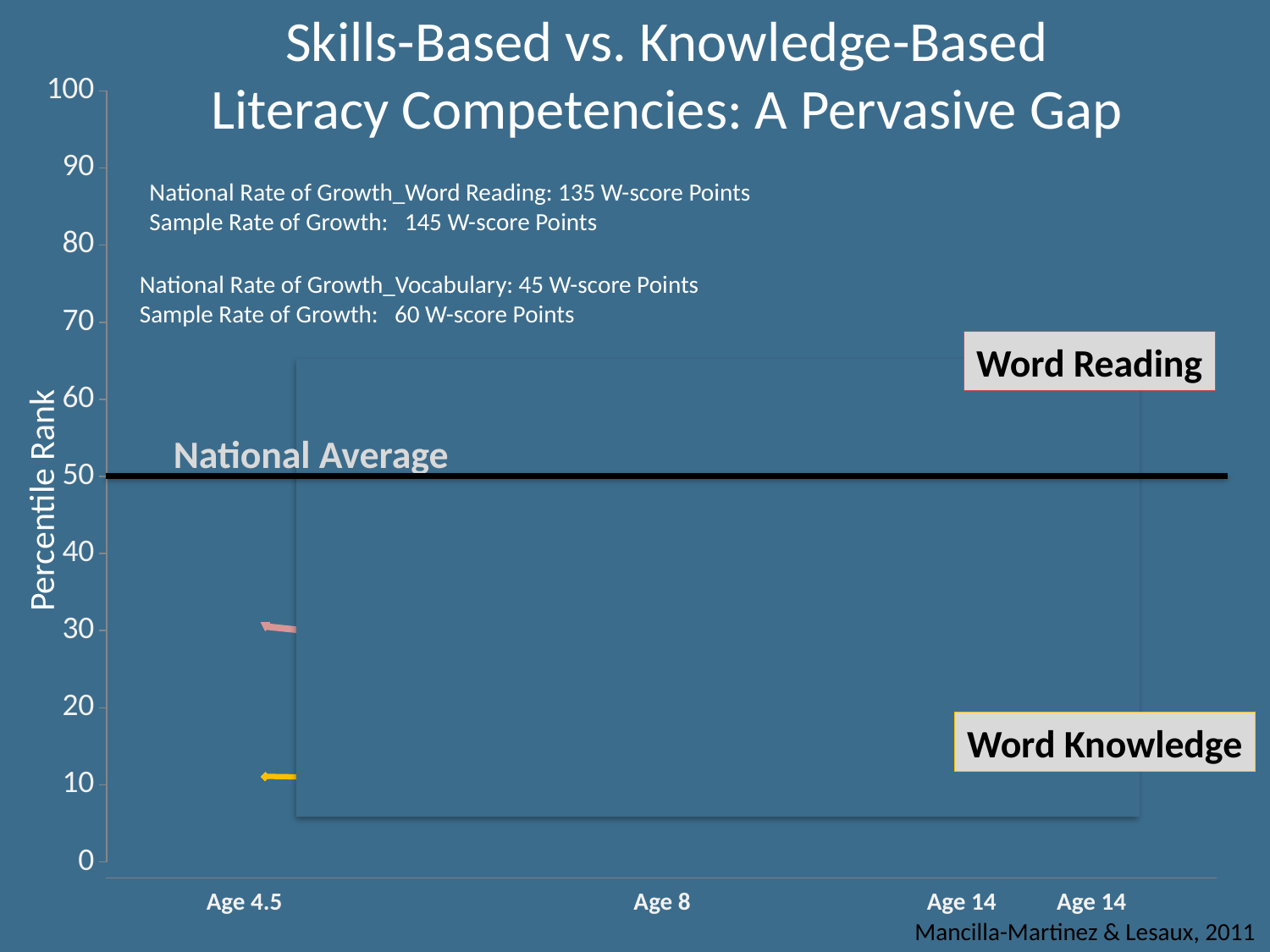
Is the Word Knowledge value at Age 4.5 greater or less than 50? less Is the Word Knowledge value at Age 4.5 greater or less than 20? less What is the title of the chart on this slide? Skills-Based vs. Knowledge-Based Literacy Competencies: A Pervasive Gap How many age categories are labelled along the x axis? 4 Is the Word Reading value at Age 4.5 greater or less than 20? greater At Age 4.5, which is higher: Word Reading or Word Knowledge? Word Reading What is the label on the vertical axis of the chart? Percentile Rank At what percentile rank is the National Average line drawn? 50 What kind of chart is shown on the slide? line chart